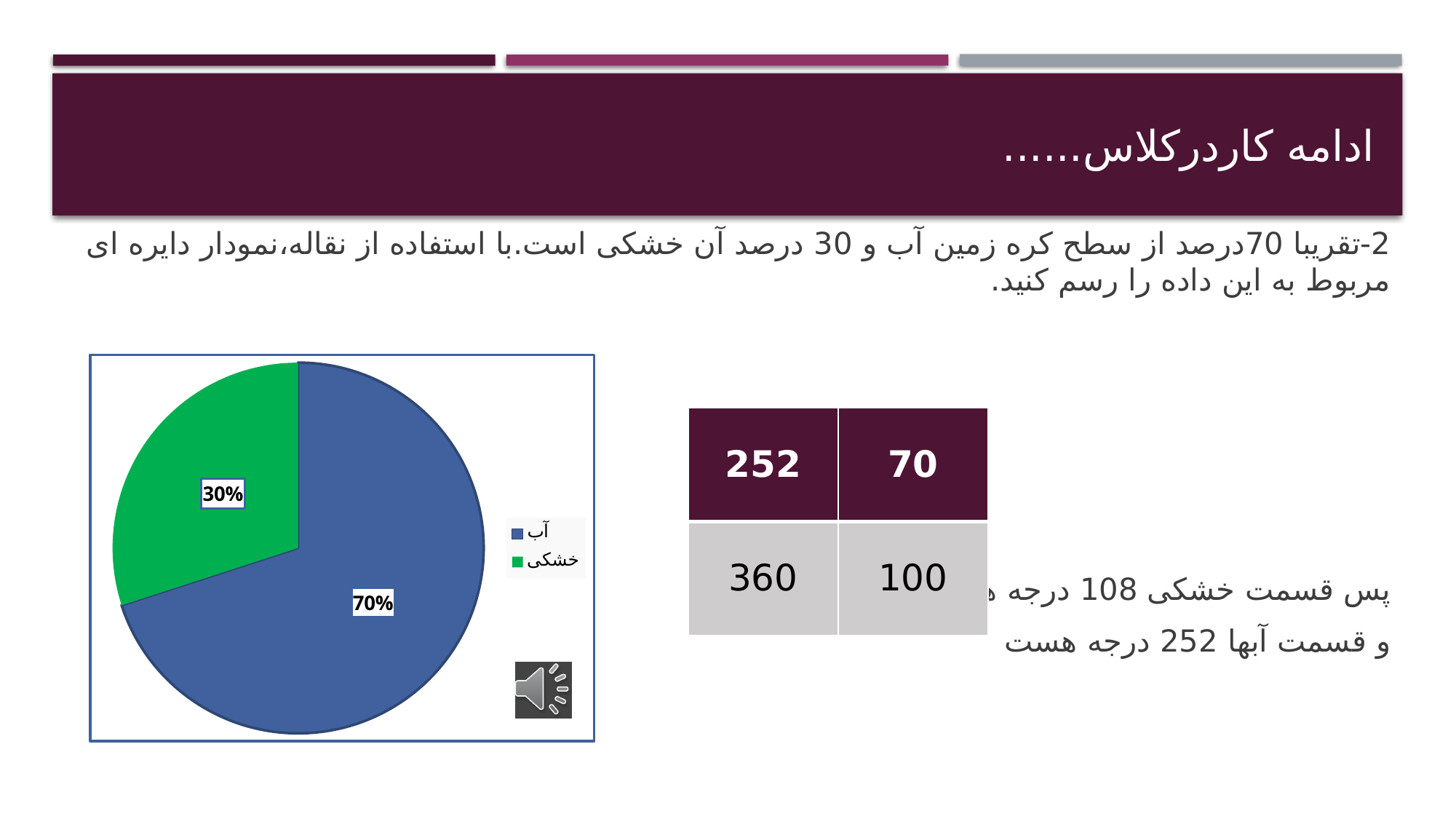
Which is larger in the pie chart, the آب slice or the خشکی slice? آب What share of the pie does the slice labelled آب represent? 70% What is the total of the two percentages shown on the pie chart? 100% How many entries does the legend of the pie chart list? 2 What share of the pie does the slice labelled خشکی represent? 30% What is the difference in percentage points between the آب slice and the خشکی slice? 40% How many slices does the pie chart have? 2 What colour is the slice labelled آب in the pie chart? blue Which slice of the pie chart is the smallest? خشکی What colour is the slice labelled خشکی in the pie chart? green What kind of chart is shown on the slide? pie chart Which slice of the pie chart is the largest? آب